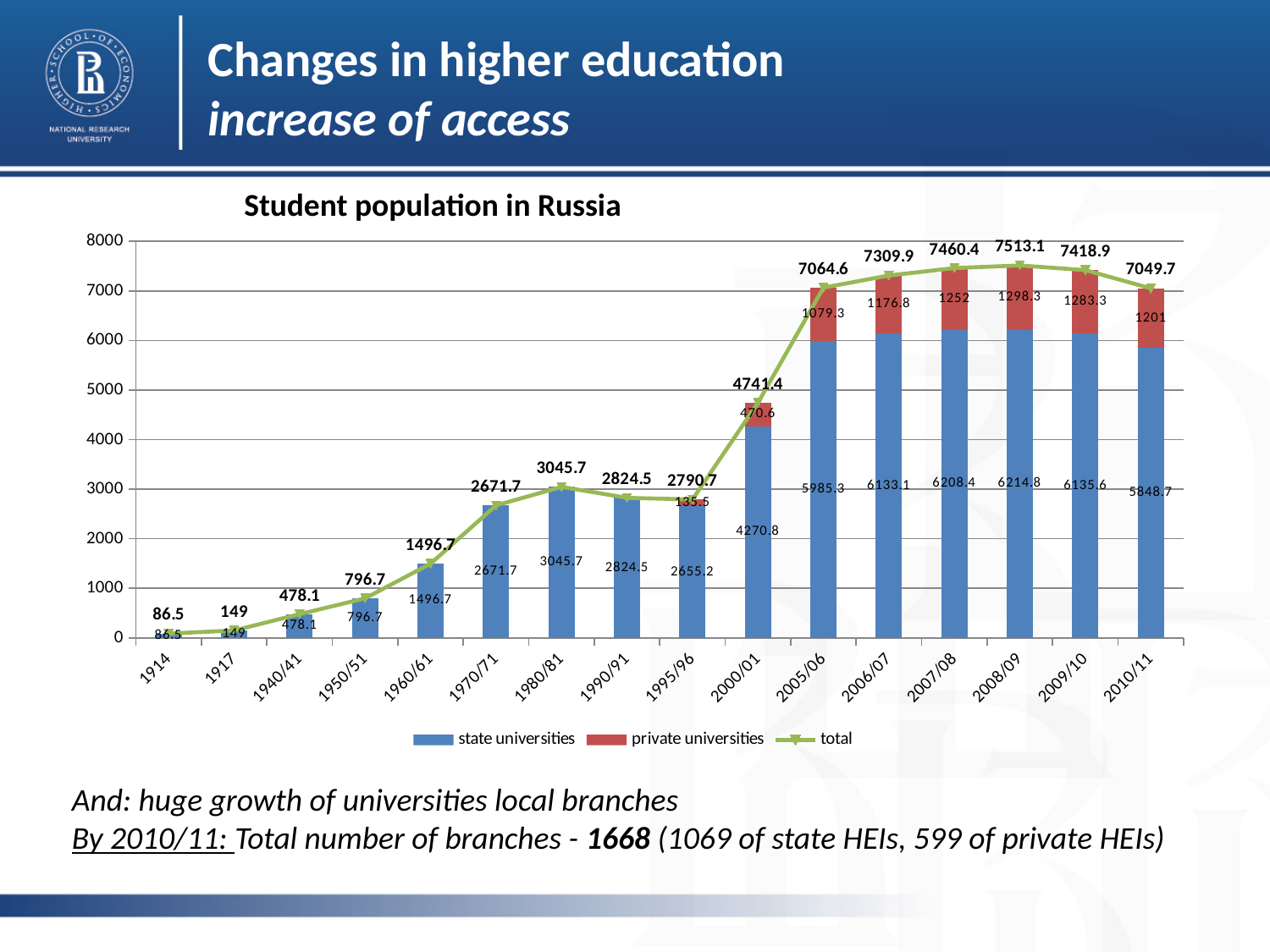
What is the total student population shown for 2008/09? 7513.1 How many years (categories) are shown on the x axis? 16 In which year is the total student population highest? 2008/09 How many series does the legend list? 3 What is the difference between the total for 2007/08 and the total for 2006/07? 150.5 In which year is the total student population lowest? 1914 What is the value for state universities in 2010/11? 5848.7 What is the title of the chart? Student population in Russia Is the value for state universities in 2000/01 greater or less than 4000? greater What is the value for private universities in 2005/06? 1079.3 What kind of chart is this? Combined stacked bar and line chart Which is larger: the state universities value in 2006/07 or in 2009/10? 2009/10